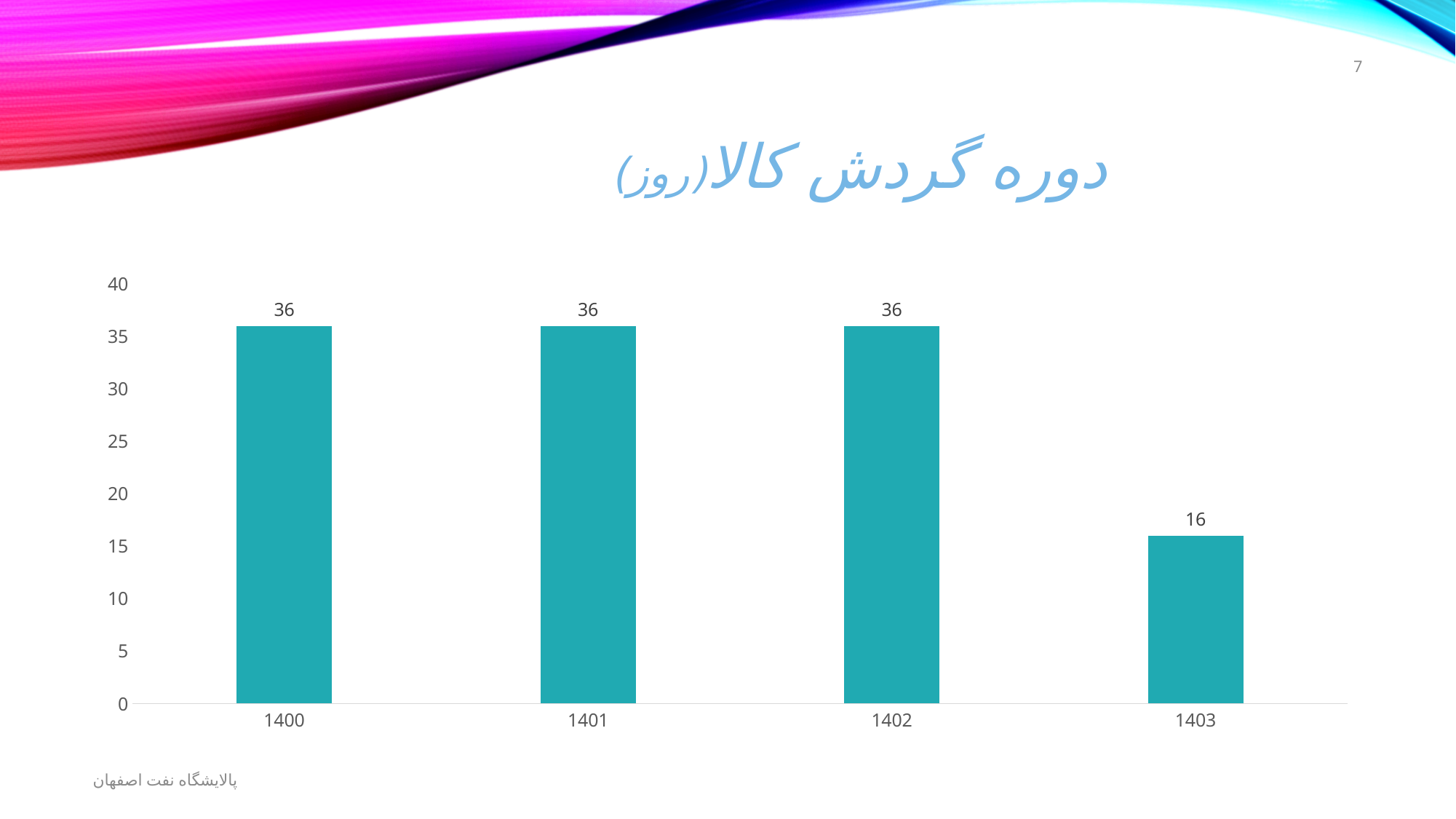
Which is larger, the value for 1401 or the value for 1403? 1401 What is the difference between the values for 1402 and 1403? 20 What is the value for 1400? 36 Do the values rise or fall from 1402 to 1403? fall What is the value for 1402? 36 What kind of chart is shown on the slide? bar chart What is the value for 1403? 16 What is the highest value shown on the y axis? 40 Is the value for 1403 greater or less than 20? less How many categories are shown on the x axis? 4 Which category has the lowest value? 1403 Is the value for 1400 greater or less than 30? greater